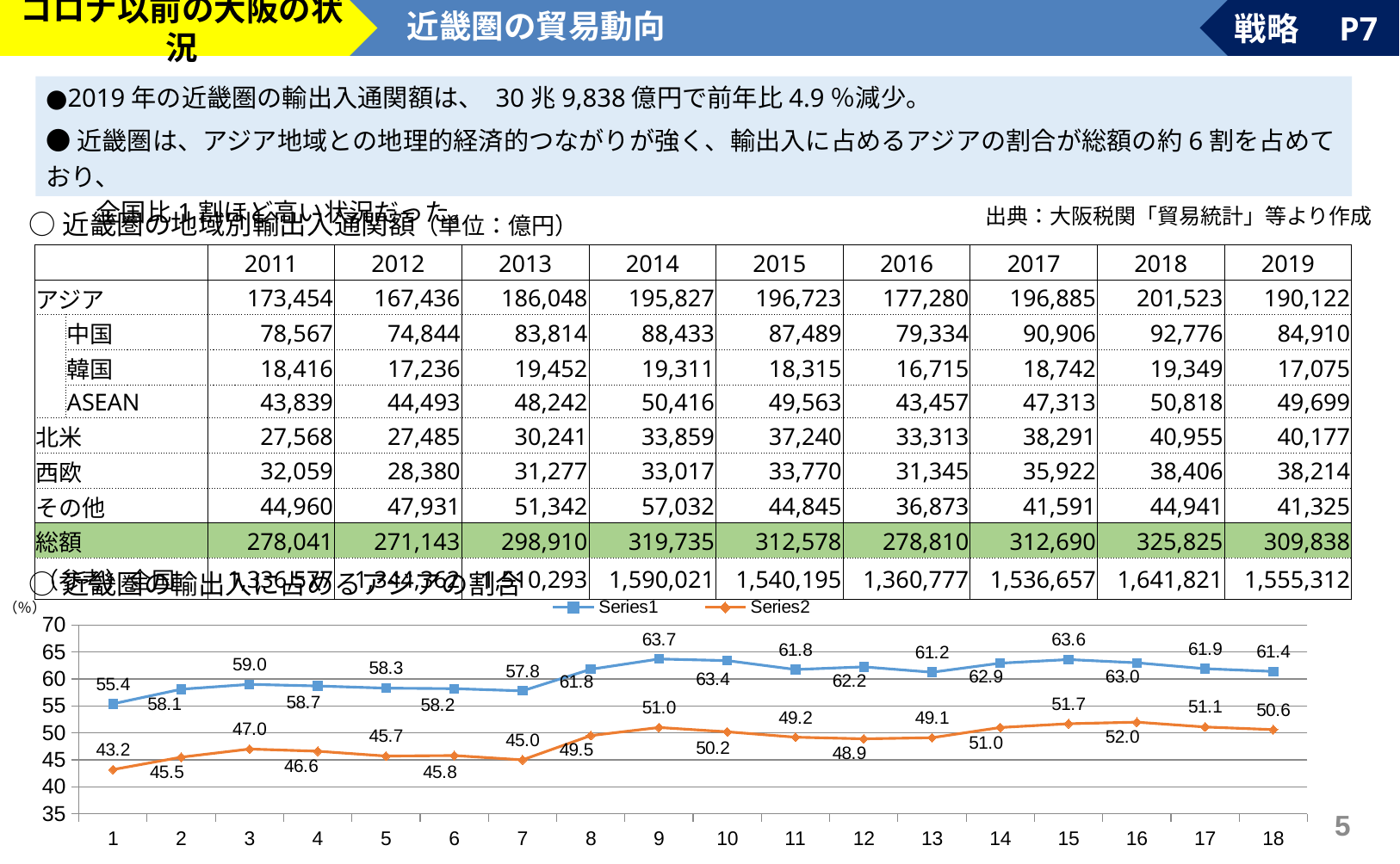
In the line chart, at which x value is Series2 lowest? 1 How many points are plotted along the x axis for each series in the line chart? 18 What kind of chart is shown at the bottom of the slide? line chart In the line chart, what is the value of Series1 at x = 1? 55.4 In the line chart, what is the difference between Series1 and Series2 at x = 18? 10.8 How many series does the legend of the line chart list? 2 In the line chart, at which x value does Series1 reach its highest value? 9 In the line chart, what colour is the line for Series2? orange In the line chart, which series has the larger value at x = 5, Series1 or Series2? Series1 In the line chart, is the value of Series2 at x = 9 greater or less than 50? greater In the line chart, what is the value of Series2 at x = 16? 52.0 In the line chart, what is the value of Series1 at x = 9? 63.7